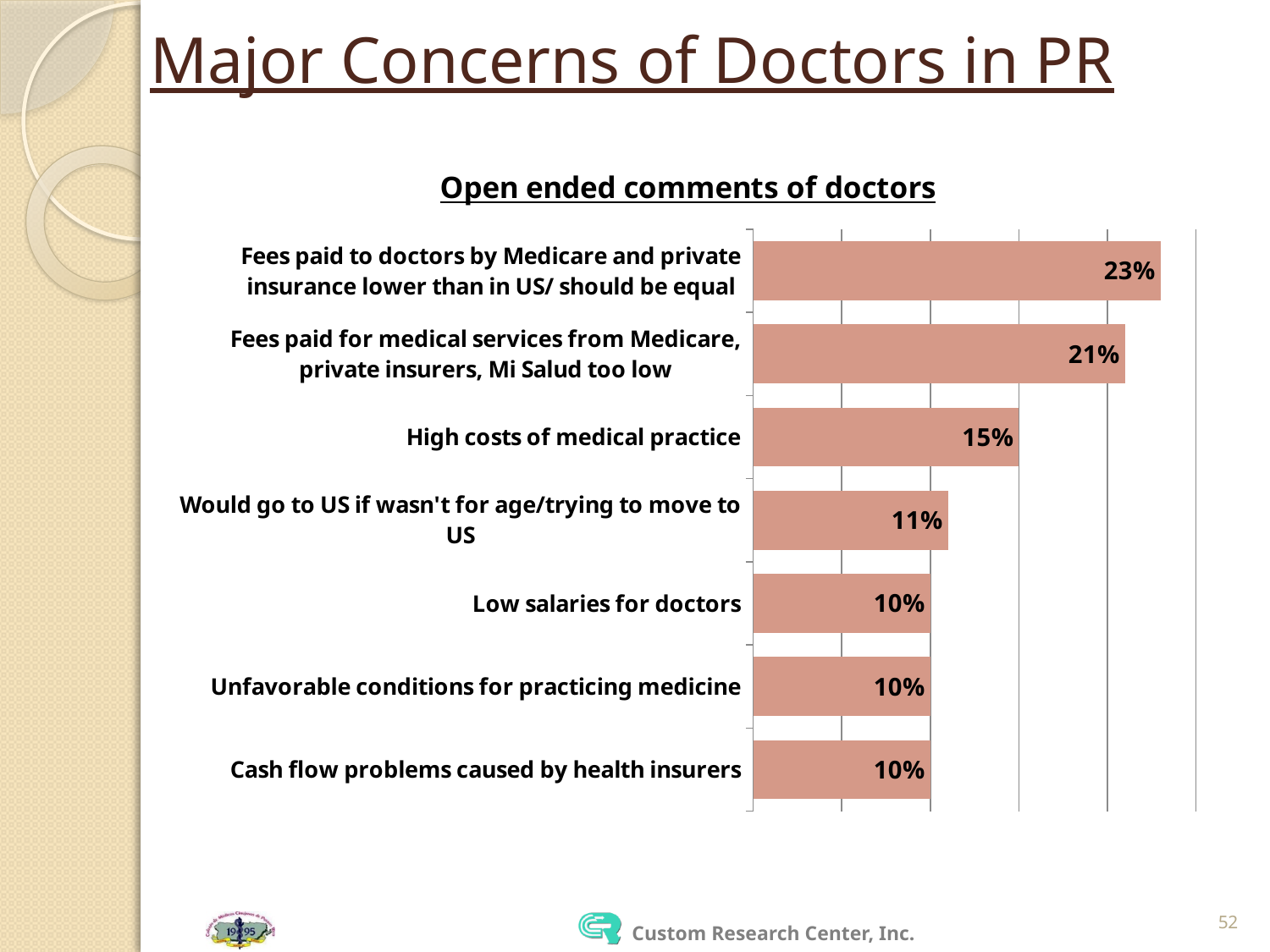
How many categories share the lowest value of 10%? 3 What is the difference between the top concern (23%) and "Fees paid for medical services from Medicare, private insurers, Mi Salud too low"? 2% What is the value for "High costs of medical practice"? 15% What percentage of doctors commented that fees paid to doctors by Medicare and private insurance are lower than in the US / should be equal? 23% Which is larger: "High costs of medical practice" or "Would go to US if wasn't for age/trying to move to US"? High costs of medical practice What kind of chart is shown on the slide? Bar chart What is the title of the chart? Open ended comments of doctors What is the value for "Cash flow problems caused by health insurers"? 10% What is the value for "Would go to US if wasn't for age/trying to move to US"? 11% What is the difference between "High costs of medical practice" and "Low salaries for doctors"? 5% How many concern categories are shown in the chart? 7 Which concern has the highest percentage? Fees paid to doctors by Medicare and private insurance lower than in US/ should be equal